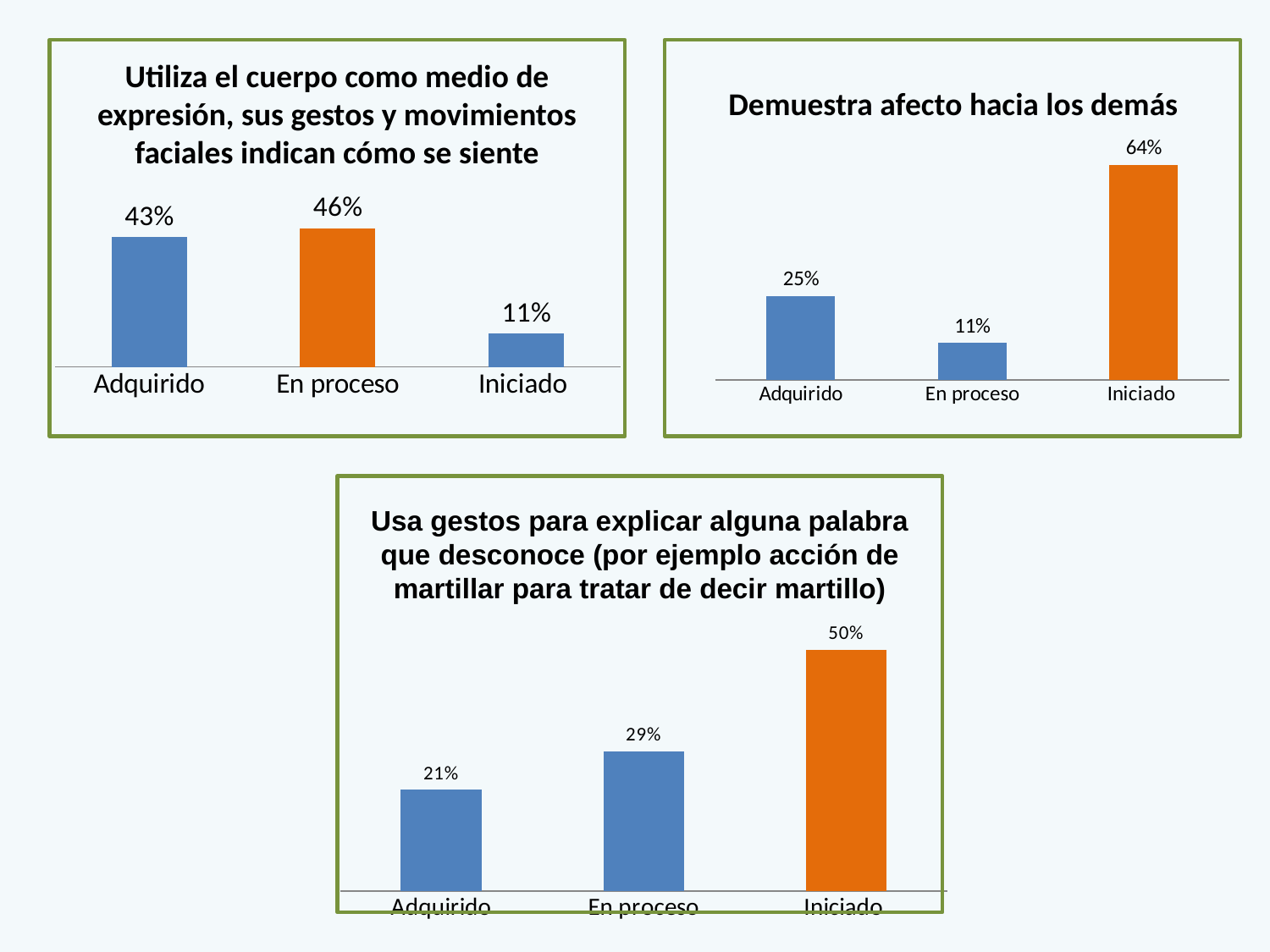
In the chart titled 'Usa gestos para explicar alguna palabra que desconoce...', which is larger, Adquirido or Iniciado? Iniciado In the chart titled 'Demuestra afecto hacia los demás', which category has the lowest value? En proceso In the chart titled 'Demuestra afecto hacia los demás', what is the value for Iniciado? 64% In the chart titled 'Demuestra afecto hacia los demás', what is the difference between Iniciado and Adquirido? 39% In the chart titled 'Utiliza el cuerpo como medio de expresión...', which category has the highest value? En proceso How many categories does the chart titled 'Demuestra afecto hacia los demás' show? 3 In the chart titled 'Utiliza el cuerpo como medio de expresión...', what is the difference between En proceso and Iniciado? 35% In the chart titled 'Utiliza el cuerpo como medio de expresión...', what is the value for Adquirido? 43% In the chart titled 'Demuestra afecto hacia los demás', what colour is the Iniciado bar? orange In the chart titled 'Usa gestos para explicar alguna palabra que desconoce...', do the values rise or fall from Adquirido to Iniciado? rise What kind of chart is the chart titled 'Usa gestos para explicar alguna palabra que desconoce...'? bar chart In the chart titled 'Usa gestos para explicar alguna palabra que desconoce...', what is the value for En proceso? 29%